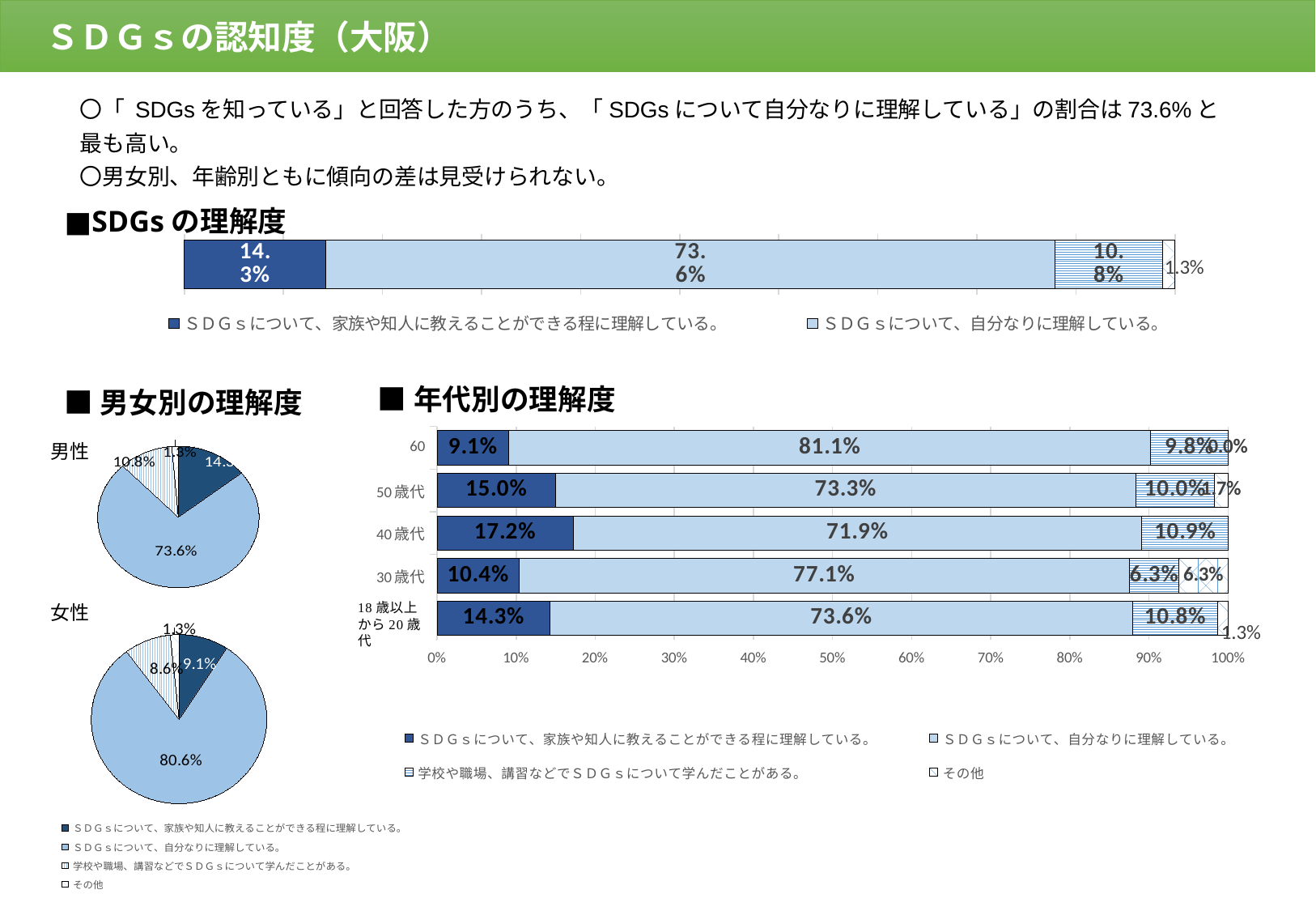
What kind of chart is the 年代別の理解度 chart? Stacked bar chart In the 年代別の理解度 chart, which age group has the highest value for ＳＤＧｓについて、家族や知人に教えることができる程に理解している? 40歳代 How many series does the legend of the 年代別の理解度 chart list? 4 In the 年代別の理解度 chart, what is the difference between 50歳代 and 30歳代 for ＳＤＧｓについて、家族や知人に教えることができる程に理解している? 4.6 percentage points In the 男性 pie chart under 男女別の理解度, what is the value for 学校や職場、講習などでＳＤＧｓについて学んだことがある? 10.8% In the 年代別の理解度 chart, which is larger for ＳＤＧｓについて、自分なりに理解している: 60 or 30歳代? 60 In the SDGsの理解度 bar at the top of the slide, what is the value for ＳＤＧｓについて、自分なりに理解している? 73.6% How many age-group categories are shown in the 年代別の理解度 chart? 5 In the 年代別の理解度 chart, what is the value for 30歳代 in the その他 series? 6.3% In the 女性 pie chart under 男女別の理解度, what share is ＳＤＧｓについて、自分なりに理解している? 80.6% In the 年代別の理解度 chart, what is the value for 60 in the ＳＤＧｓについて、自分なりに理解している series? 81.1% In the 年代別の理解度 chart, which age group has the lowest value for ＳＤＧｓについて、自分なりに理解している? 40歳代